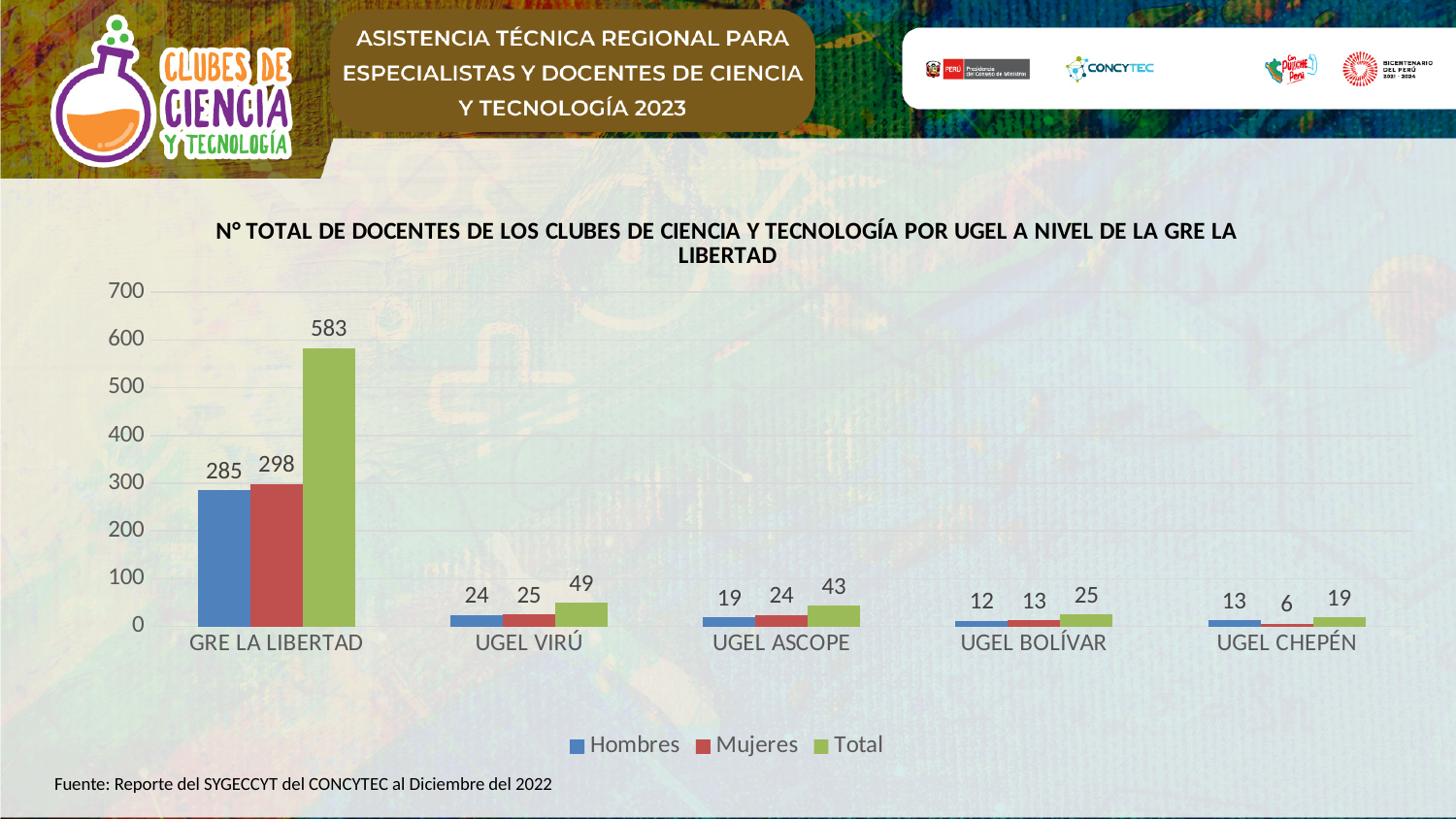
Which is larger for UGEL CHEPÉN, the Hombres value or the Mujeres value? Hombres What is the Hombres value for GRE LA LIBERTAD? 285 Which category has the highest Total value? GRE LA LIBERTAD What colour represents the Total series in the legend? Green What is the difference between the Mujeres and Hombres values for GRE LA LIBERTAD? 13 How many series does the legend list? 3 How many categories are shown on the x axis? 5 Which category has the lowest Total value? UGEL CHEPÉN What is the Total value for UGEL ASCOPE? 43 Is the Total value for GRE LA LIBERTAD greater or less than 500? greater What is the Mujeres value for UGEL CHEPÉN? 6 What kind of chart is shown on the slide? Bar chart